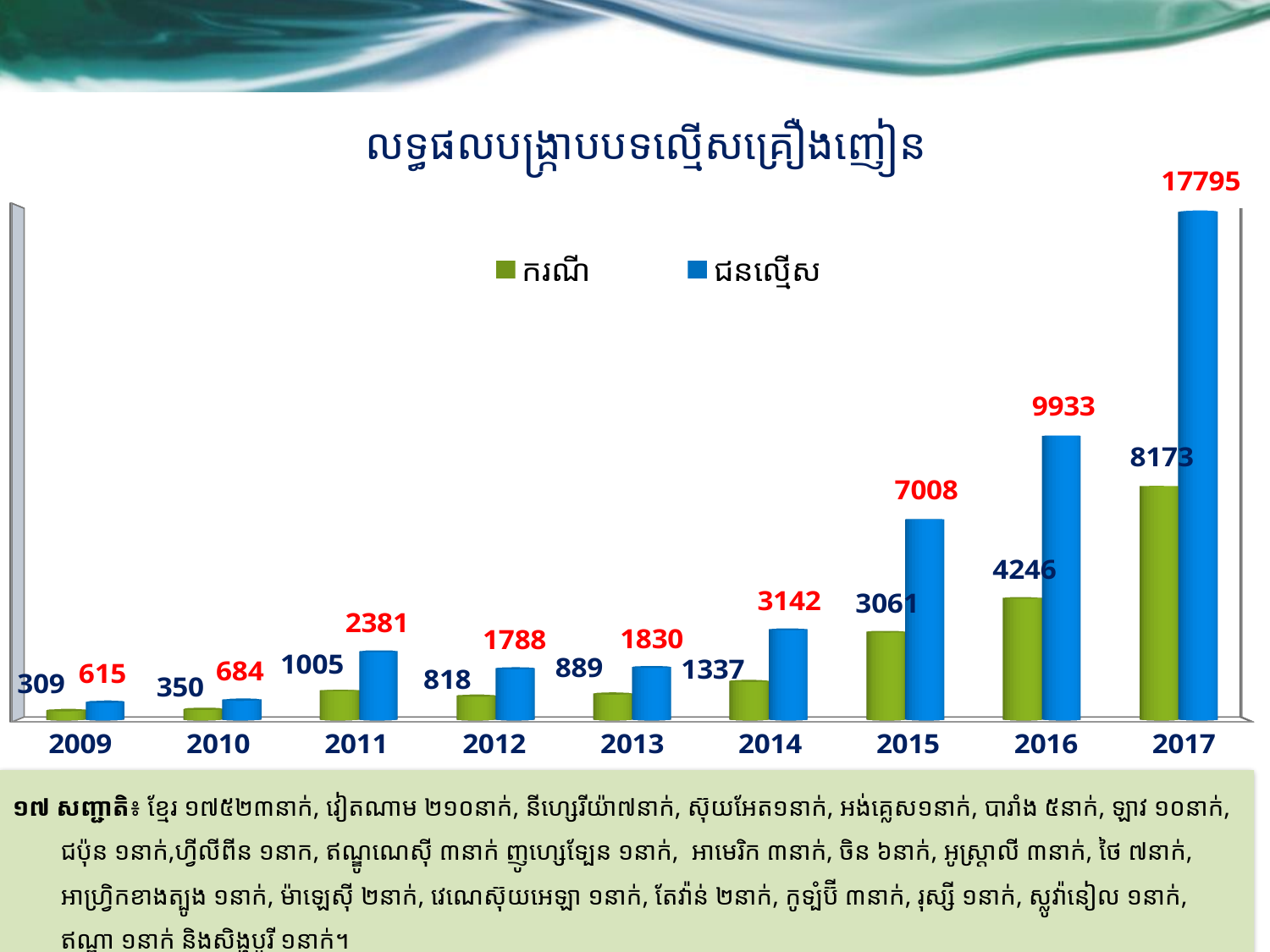
How many series does the legend list? 2 How many years are shown on the x axis? 9 Which year has the highest value for the ករណី series? 2017 Does the ជនល្មើស series generally rise or fall from 2013 to 2017? rise What kind of chart is shown on the slide? bar chart What is the value of the ជនល្មើស series for 2012? 1788 What is the value of the ករណី series for 2015? 3061 Which is larger, the ករណី value for 2012 or the ករណី value for 2013? 2013 What colour are the bars for the ជនល្មើស series? blue Which year has the lowest value for the ជនល្មើស series? 2009 What is the difference between the ជនល្មើស and ករណី values in 2016? 5687 What is the value of the ជនល្មើស series for 2017? 17795